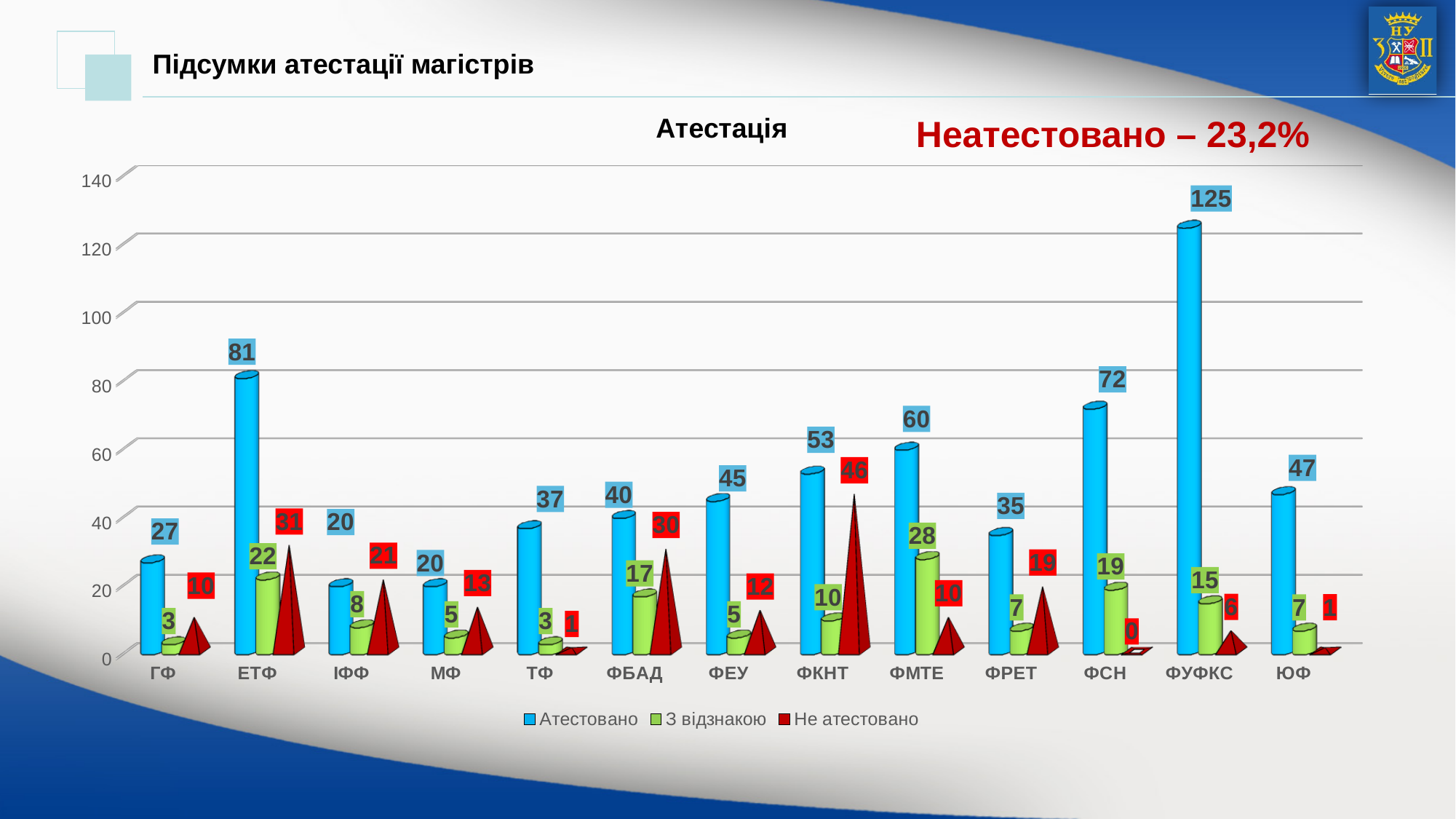
How many categories are shown on the x axis? 13 Which category has the lowest Не атестовано value? ФСН Which category has the highest Атестовано value? ФУФКС What is the difference between the Атестовано values for ЕТФ and ФСН? 9 What is the value of З відзнакою for ФМТЕ? 28 What is the value of Не атестовано for ФКНТ? 46 Which is larger: the Не атестовано value for ІФФ or the Атестовано value for ІФФ? Не атестовано (21) What is the title of the chart? Атестація What is the value of Атестовано for ФУФКС? 125 What percentage of students were not certified according to the text on the slide? 23,2% How many series does the legend list? 3 What kind of chart is shown on the slide? Bar chart